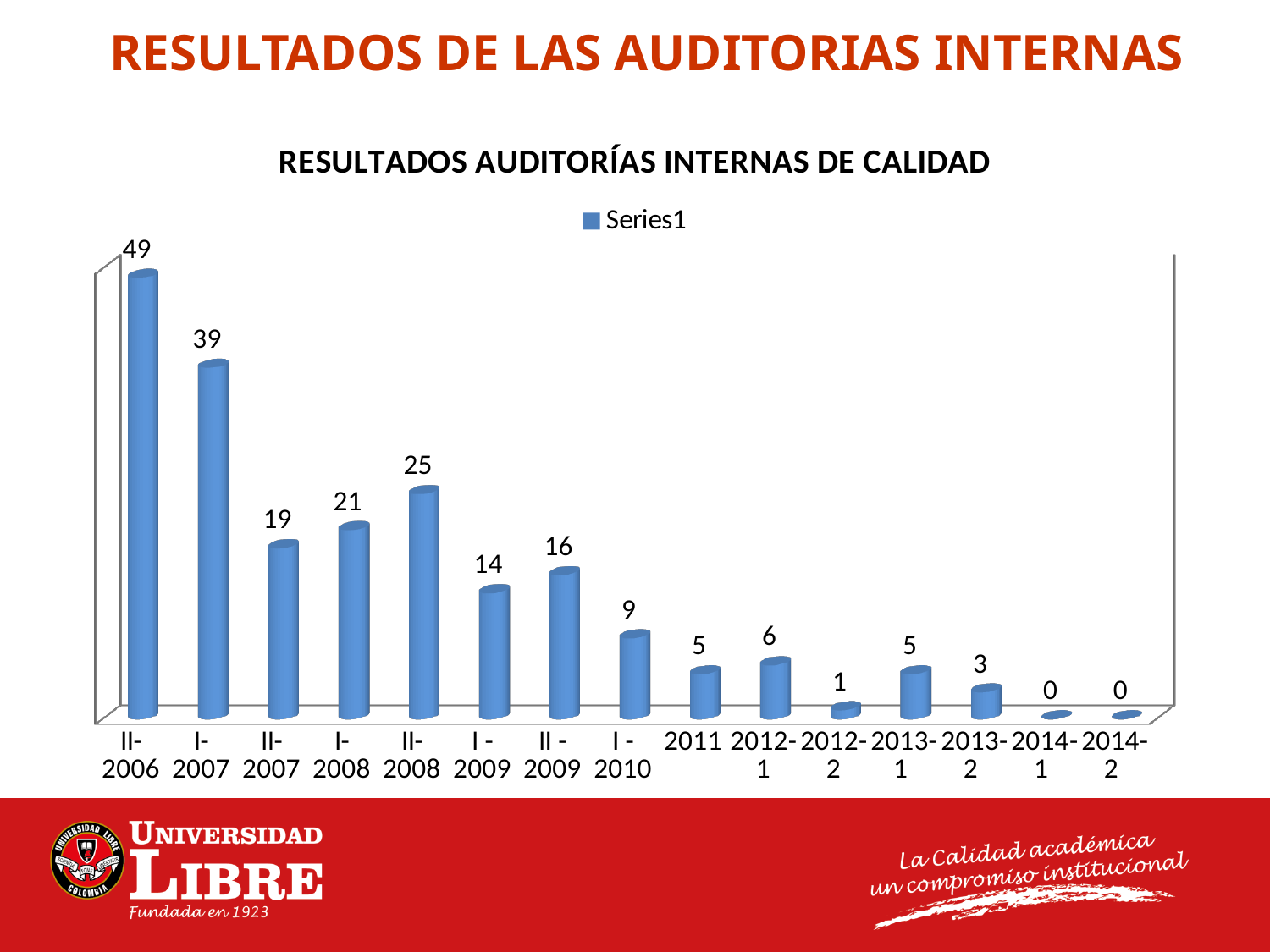
What is the value for II-2008? 25 What is the difference between the values for II-2006 and I-2007? 10 Which is larger, the value for I-2008 or the value for II-2007? I-2008 How many categories are shown on the x axis? 15 Which category has the highest value? II-2006 What kind of chart is shown on the slide? bar chart What is the value for 2012-2? 1 What is the difference between the values for II-2009 and I-2009? 2 What is the title of the chart? RESULTADOS AUDITORÍAS INTERNAS DE CALIDAD Do the values generally rise or fall from II-2006 to 2014-2? fall How many series does the legend list? 1 What is the value for II-2006? 49